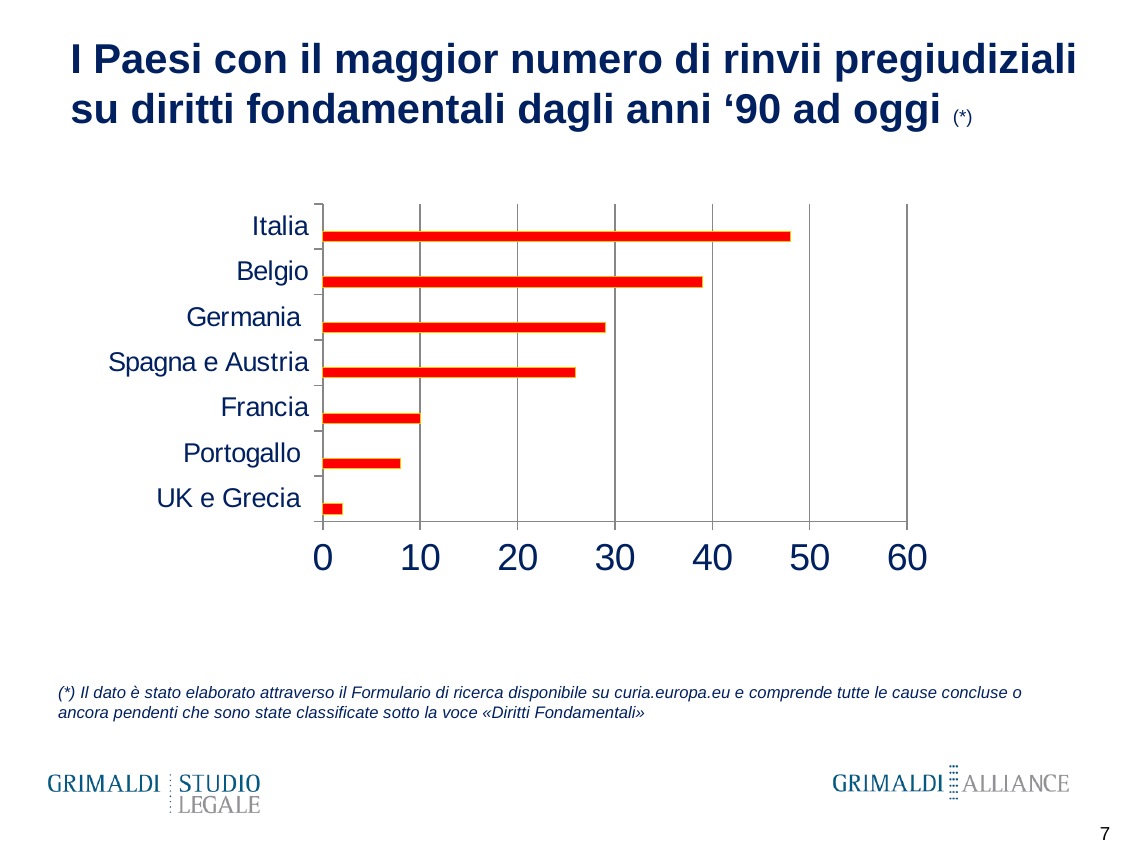
What is the highest value shown on the horizontal axis of the chart? 60 How many categories are plotted in the chart? 7 Is the value for Belgio greater or less than 30? greater Is the value for Italia greater or less than 40? greater What kind of chart is shown on the slide? bar chart Is the value for UK e Grecia greater or less than 10? less Which category has the lowest value in the chart? UK e Grecia Which category has the highest value in the chart? Italia Do the bar values increase or decrease going from the top category to the bottom category? decrease Which has the larger value, Francia or Portogallo? Francia Which has the larger value, Italia or Belgio? Italia